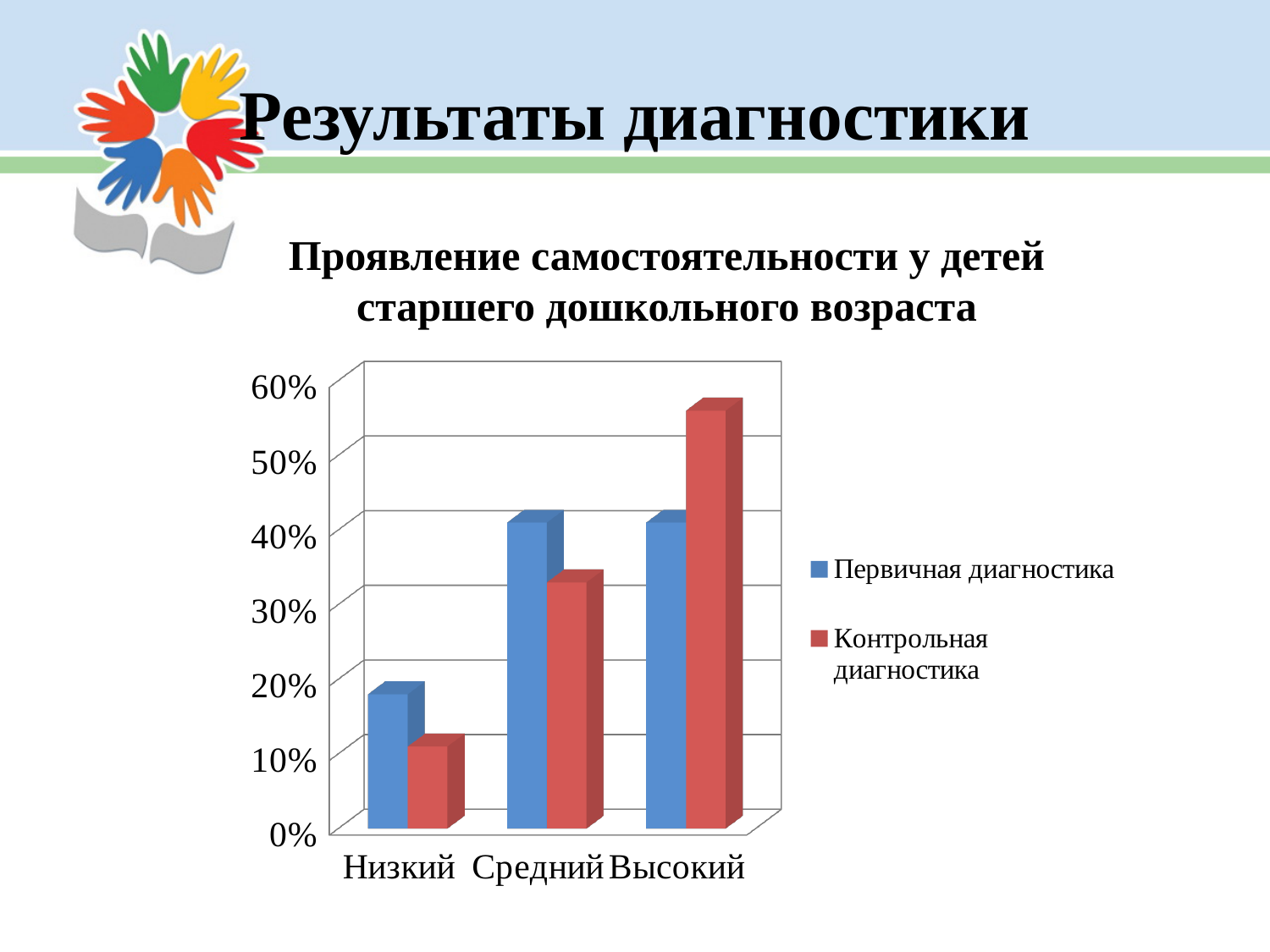
What kind of chart is shown on the slide? Bar chart For which category is the value of Первичная диагностика lowest? Низкий Is the value of Контрольная диагностика for Высокий greater or less than 50%? greater How many categories are shown on the x axis of the chart? 3 For the Высокий category, which series has the larger value, Первичная диагностика or Контрольная диагностика? Контрольная диагностика Is the value of Контрольная диагностика for Низкий greater or less than 20%? less For the Низкий category, which series has the larger value, Первичная диагностика or Контрольная диагностика? Первичная диагностика What is the title of the chart? Проявление самостоятельности у детей старшего дошкольного возраста How many series does the chart legend list? 2 Which series is shown in red in the chart? Контрольная диагностика For which category is the value of Контрольная диагностика lowest? Низкий For which category is the value of Контрольная диагностика highest? Высокий